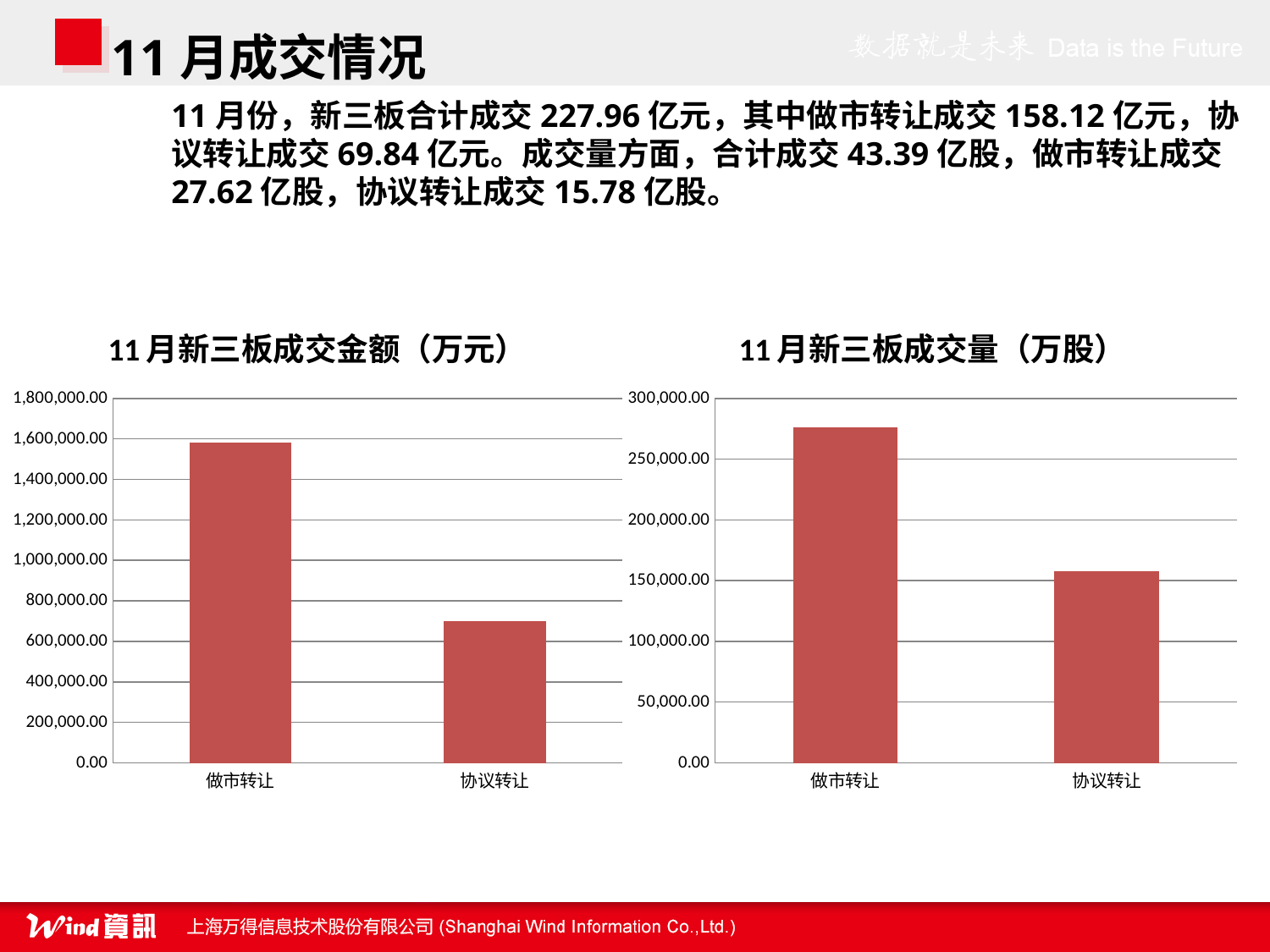
What is the title of the chart on the left side of the slide? 11月新三板成交金额（万元） In the "11月新三板成交量（万股）" chart, which category has the highest value? 做市转让 How many categories are shown in the "11月新三板成交量（万股）" chart? 2 In the "11月新三板成交量（万股）" chart, is the value for 协议转让 greater or less than 200,000.00? less In the "11月新三板成交金额（万元）" chart, is the value for 协议转让 greater or less than 800,000.00? less What kind of chart is the "11月新三板成交量（万股）" chart on the right? bar chart In the "11月新三板成交量（万股）" chart, is the value for 做市转让 greater or less than 250,000.00? greater In the "11月新三板成交量（万股）" chart, which category has the lowest value? 协议转让 In the "11月新三板成交金额（万元）" chart, which category has the highest value? 做市转让 In the "11月新三板成交金额（万元）" chart, which category has the lowest value? 协议转让 What kind of chart is the "11月新三板成交金额（万元）" chart on the left? bar chart